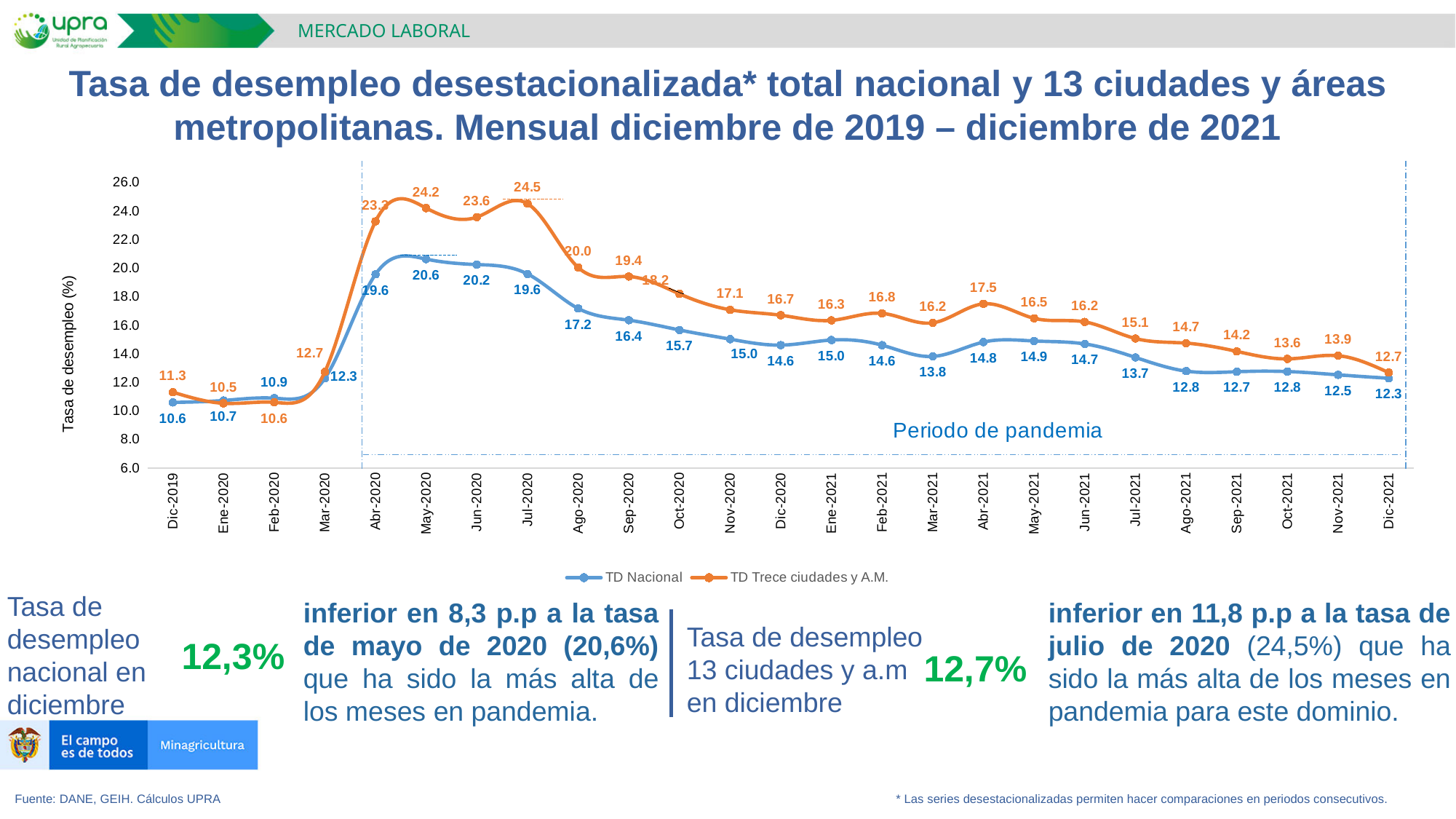
What is the difference between TD Trece ciudades y A.M. and TD Nacional in Dic-2021? 0.4 In which month does the TD Nacional series have its lowest value? Dic-2019 Is the value of TD Nacional in Abr-2020 greater or less than 18.0? greater In which month does the TD Trece ciudades y A.M. series reach its highest value? Jul-2020 How many months are plotted on the x axis? 25 What is the value of TD Nacional in May-2020? 20.6 What kind of chart is shown on the slide? Line chart What is the value of TD Nacional in Dic-2021? 12.3 Does the TD Nacional series rise or fall from Jul-2021 to Dic-2021? Fall What is the value of TD Trece ciudades y A.M. in Jul-2020? 24.5 Which series has the higher value in Abr-2021, TD Nacional or TD Trece ciudades y A.M.? TD Trece ciudades y A.M. How many series does the legend list? 2